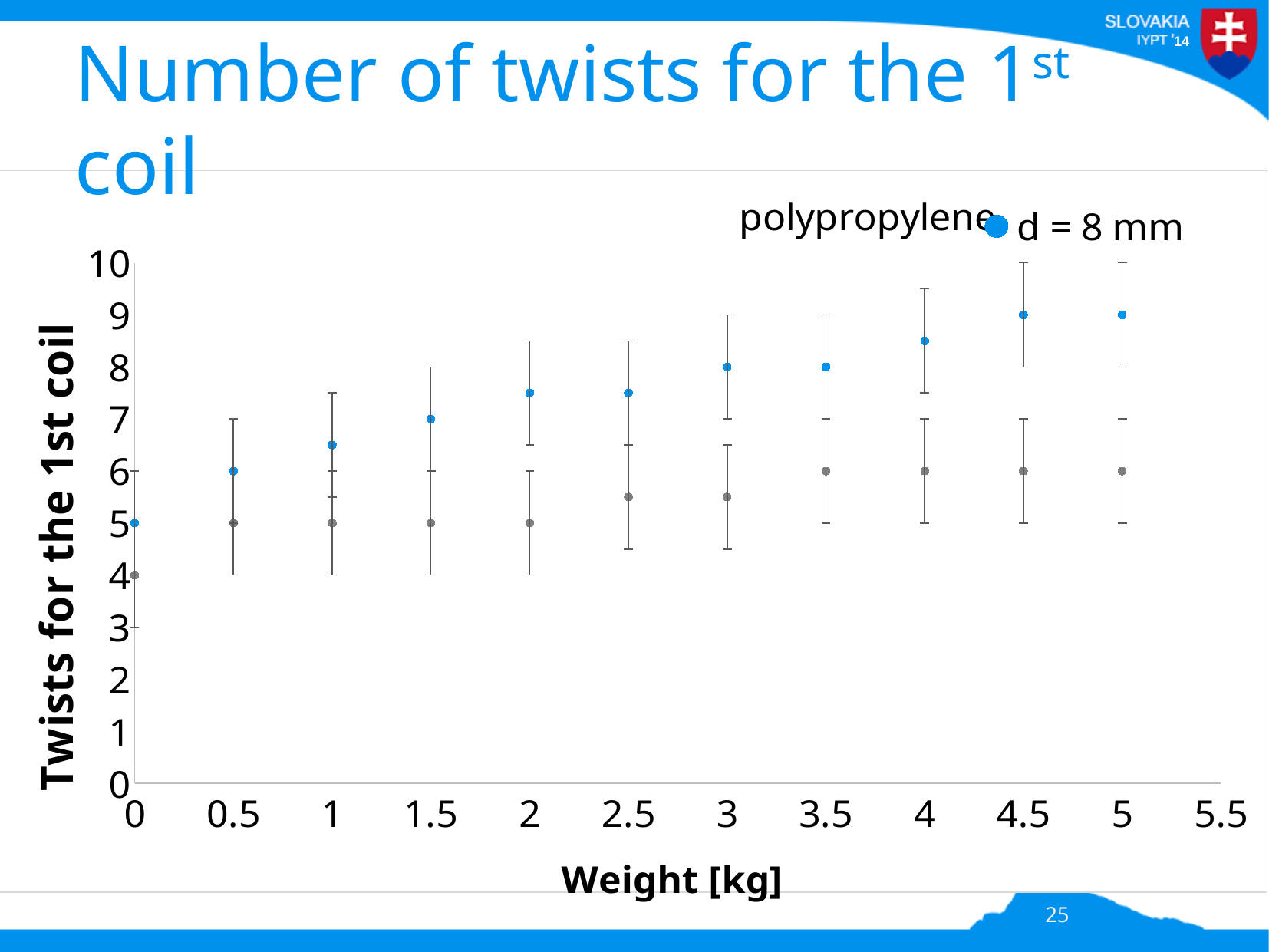
Do the blue (polypropylene d = 8 mm) values rise or fall as weight increases? Rise How many blue data points are plotted on the chart? 11 What is the label of the x axis? Weight [kg] How many series does the chart legend list? 1 What is the number of twists for the blue series at a weight of 0 kg? 5 What is the number of twists for the blue series at a weight of 5 kg? 9 What is the legend entry for the blue series? d = 8 mm What is the number of twists for the blue series at a weight of 1.5 kg? 7 At which weight is the blue series value lowest? 0 kg What kind of chart is shown on the slide? Scatter chart At a weight of 4 kg, is the blue series value greater or less than 8? greater At a weight of 3 kg, which series has the higher value, the blue series or the grey series? Blue series